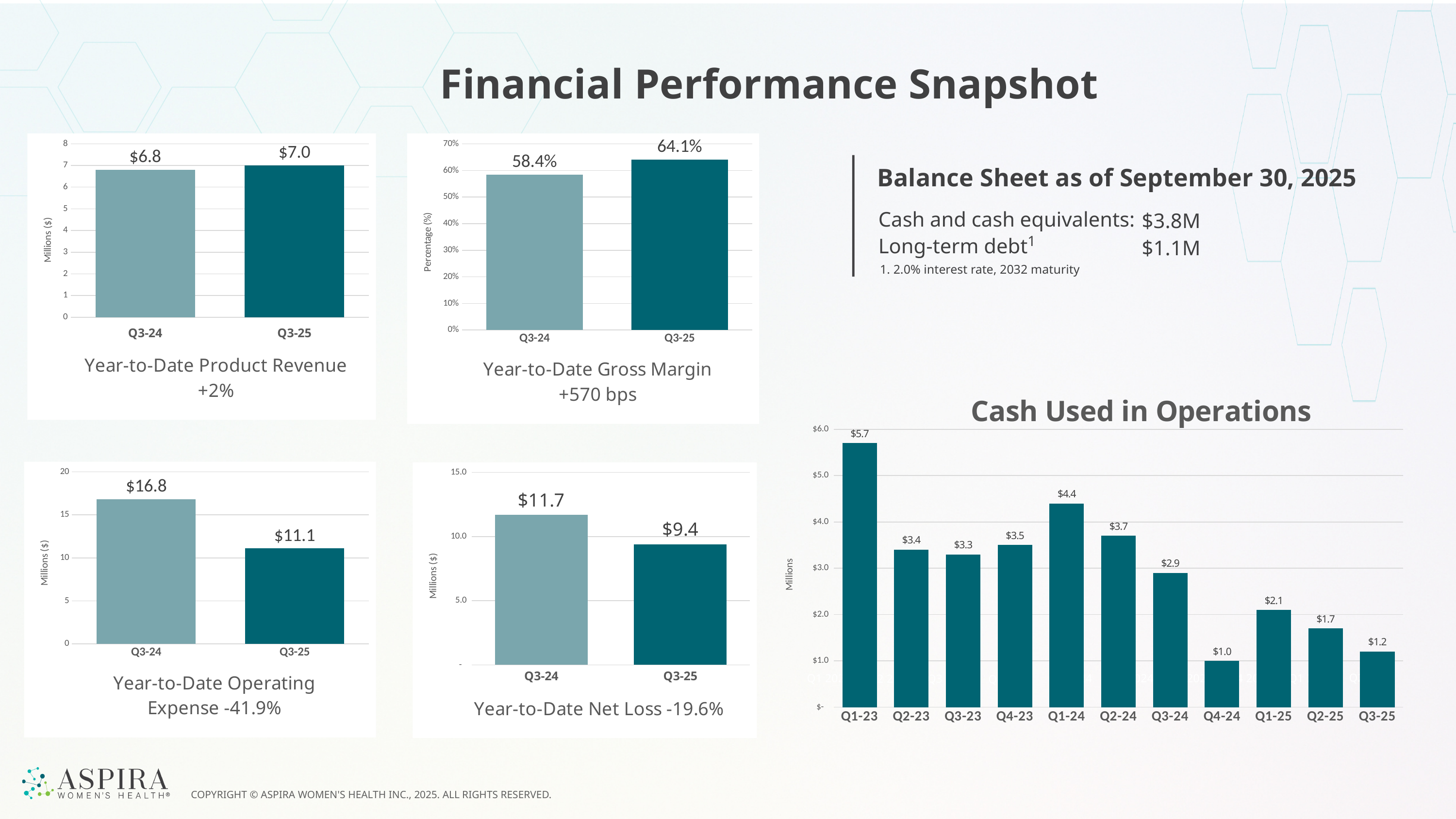
In the Year-to-Date Operating Expense chart, what is the difference between the Q3-24 and Q3-25 values? $5.7 What kind of chart is the Cash Used in Operations chart? Bar chart In the Cash Used in Operations chart, which quarter has the highest value? Q1-23 In the Cash Used in Operations chart, what is the value for Q1-24? $4.4 In the Year-to-Date Net Loss chart, which quarter has the larger value, Q3-24 or Q3-25? Q3-24 In the Cash Used in Operations chart, which quarter has the lowest value? Q4-24 What is the y-axis label of the Cash Used in Operations chart? Millions In the Year-to-Date Product Revenue chart, what is the value for Q3-25? $7.0 In the Year-to-Date Gross Margin chart, does the value rise or fall from Q3-24 to Q3-25? Rise In the Year-to-Date Gross Margin chart, what is the value for Q3-24? 58.4% In the Cash Used in Operations chart, what is the difference between the Q2-24 and Q3-24 values? $0.8 How many quarters are shown in the Cash Used in Operations chart? 11